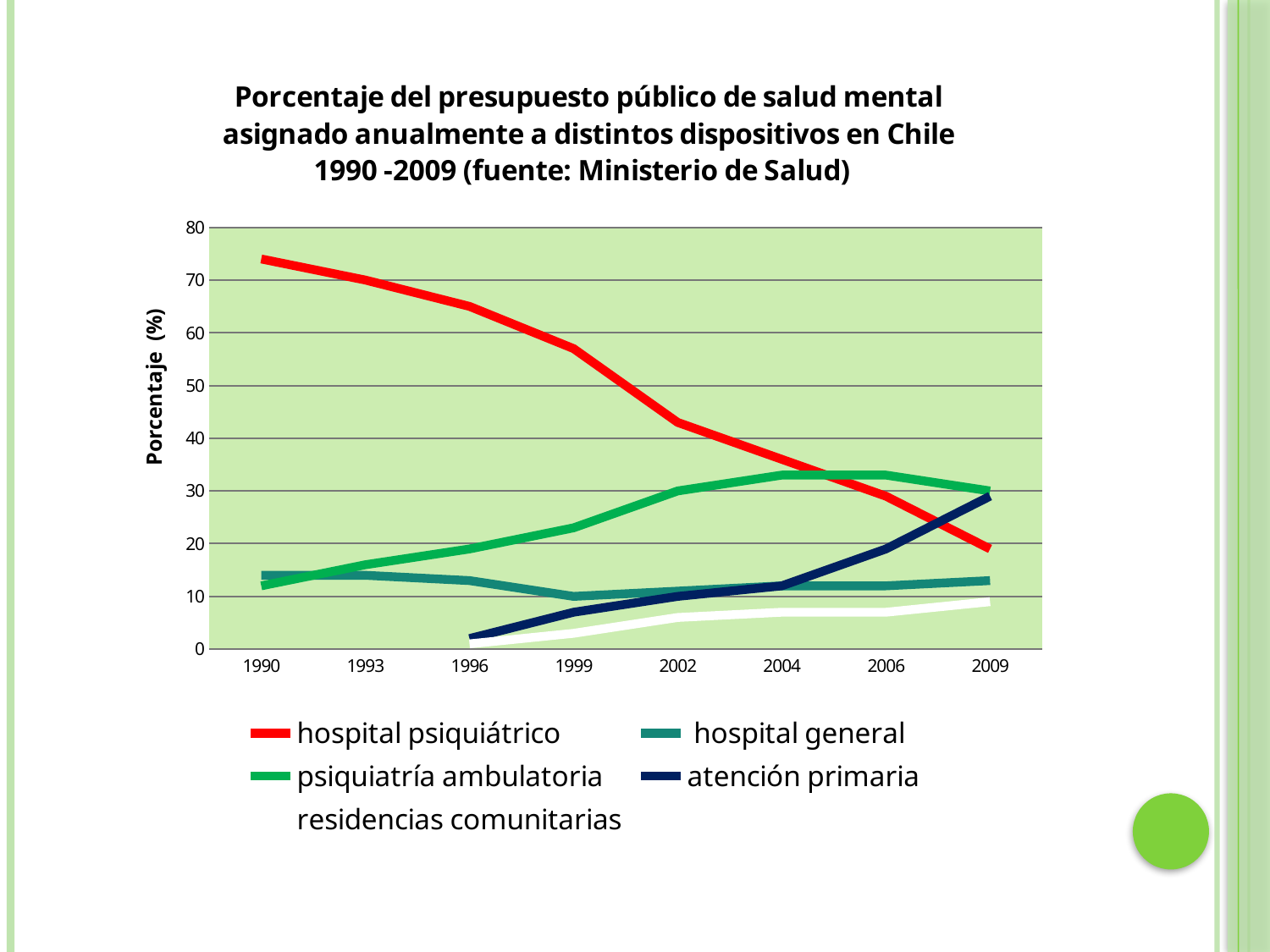
Which series has the lowest value in 2009? residencias comunitarias Is the value for psiquiatría ambulatoria in 2004 greater or less than 30? greater Which series has the highest value in 1990? hospital psiquiátrico Is the value for hospital psiquiátrico in 1990 greater or less than 70? greater In 2009, which is larger: psiquiatría ambulatoria or hospital psiquiátrico? psiquiatría ambulatoria Does the atención primaria line rise or fall from 1996 to 2009? rise How many series does the legend list? 5 What kind of chart is shown on the slide? line chart What colour is the hospital psiquiátrico line? red How many years are shown on the x axis? 8 Is the value for hospital psiquiátrico in 2009 greater or less than 30? less Does the hospital psiquiátrico line rise or fall from 1990 to 2009? fall